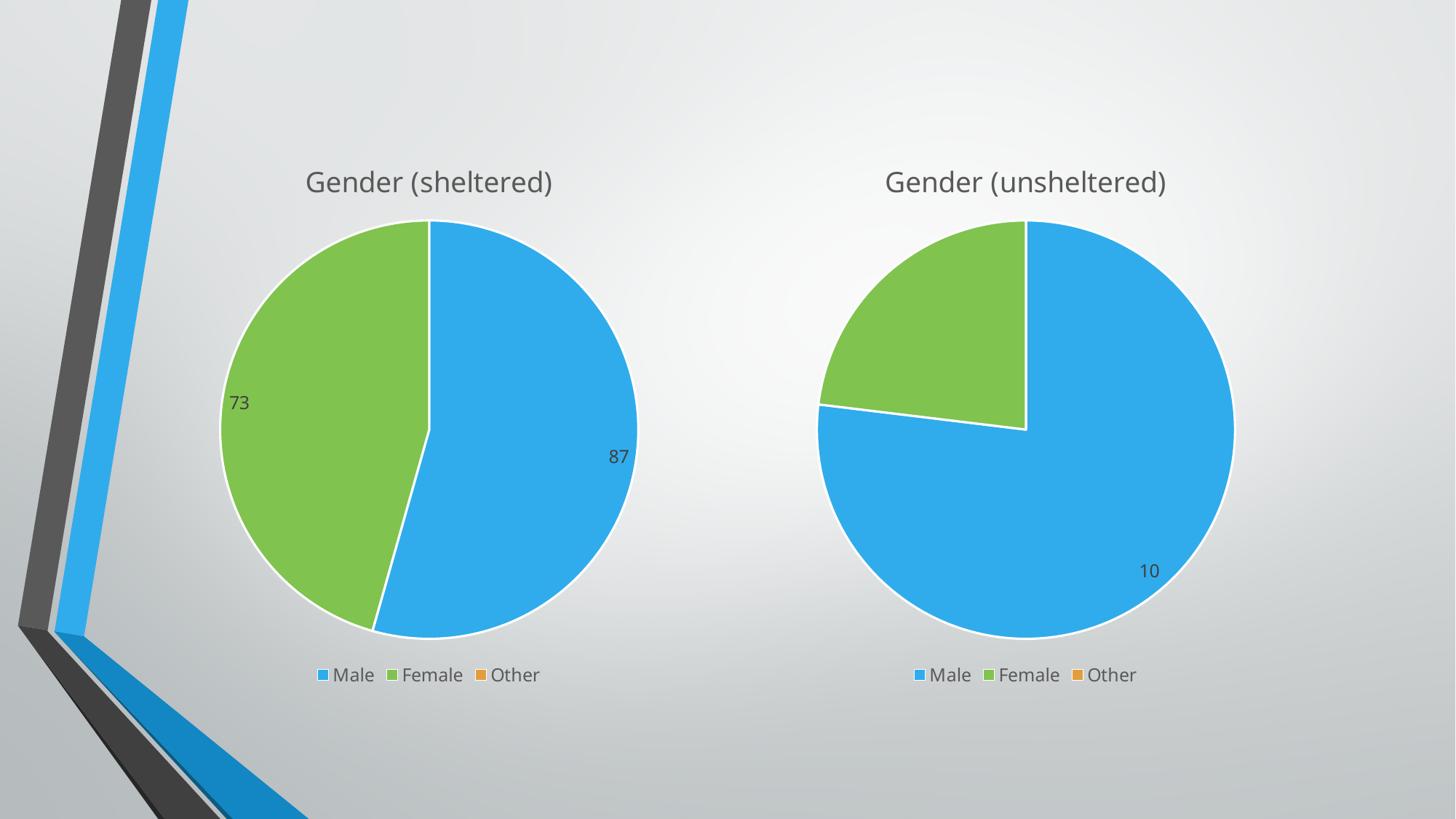
In the Gender (sheltered) chart, what is the value for Female? 73 What is the title of the chart on the right side of the slide? Gender (unsheltered) In the Gender (unsheltered) chart, what is the value for Male? 10 In the Gender (unsheltered) chart, which category has the largest slice? Male In the Gender (unsheltered) chart, which is larger, Male or Female? Male What kind of chart is the Gender (unsheltered) chart? Pie chart In the Gender (sheltered) chart, what is the difference between the Male and Female values? 14 How many entries does the legend of the Gender (sheltered) chart list? 3 In the Gender (sheltered) chart, which category has the largest slice? Male In the Gender (sheltered) chart, which is larger, Male or Female? Male In the Gender (sheltered) chart, what colour is the Female slice? Green In the Gender (sheltered) chart, what is the value for Male? 87